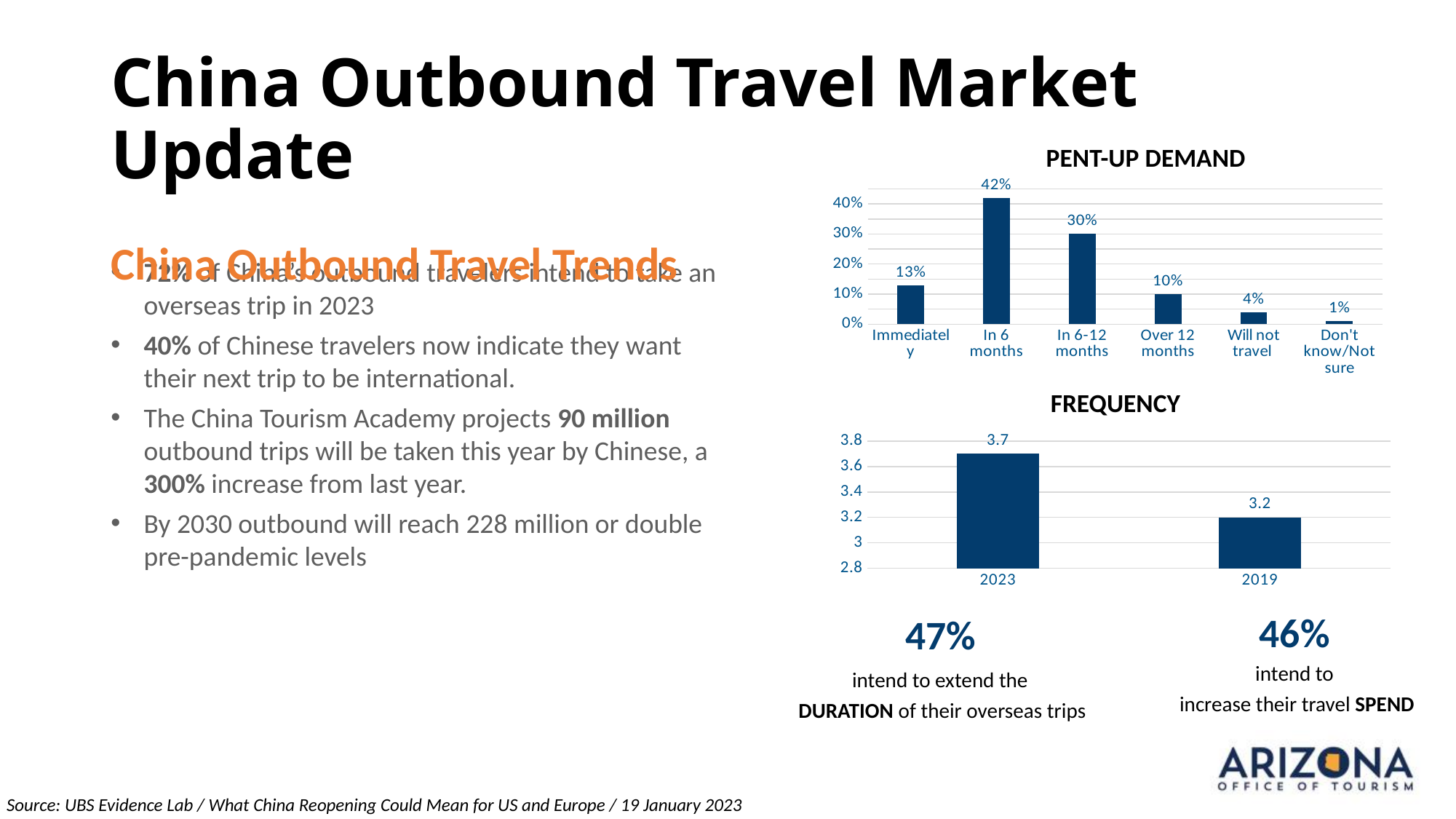
What kind of chart is the PENT-UP DEMAND chart? Bar chart In the FREQUENCY chart, what is the value for 2023? 3.7 In the PENT-UP DEMAND chart, what is the difference between 'In 6 months' and 'In 6-12 months'? 12% How many categories are shown in the PENT-UP DEMAND chart? 6 In the PENT-UP DEMAND chart, what is the value for 'In 6 months'? 42% In the PENT-UP DEMAND chart, which category has the lowest value? Don't know/Not sure In the PENT-UP DEMAND chart, which is larger: 'Immediately' or 'Will not travel'? Immediately In the FREQUENCY chart, which year has the higher value? 2023 In the FREQUENCY chart, what is the difference between the 2023 and 2019 values? 0.5 In the FREQUENCY chart, what is the value for 2019? 3.2 In the PENT-UP DEMAND chart, what is the value for 'Over 12 months'? 10% In the PENT-UP DEMAND chart, which category has the highest value? In 6 months